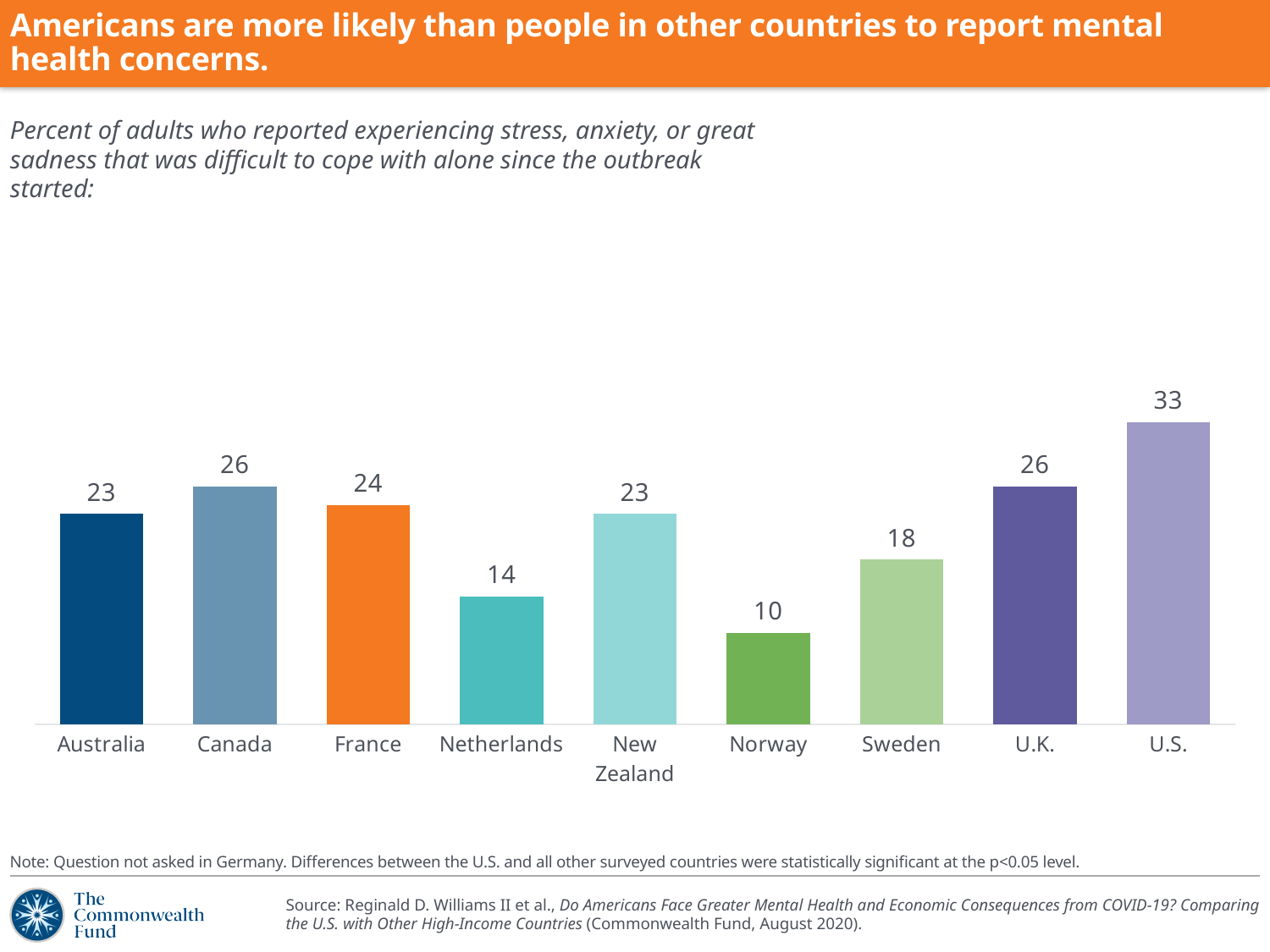
What is the difference between the values for Canada and the Netherlands? 12 Which country has the lowest value? Norway Which country has the highest value? U.S. Which is larger, the value for France or the value for Sweden? France What is the value for the U.S.? 33 What is the difference between the values for the U.S. and the U.K.? 7 How many countries are shown in the chart? 9 What is the value for Norway? 10 What kind of chart is shown on the slide? Bar chart What is the value for Sweden? 18 What is the value for the Netherlands? 14